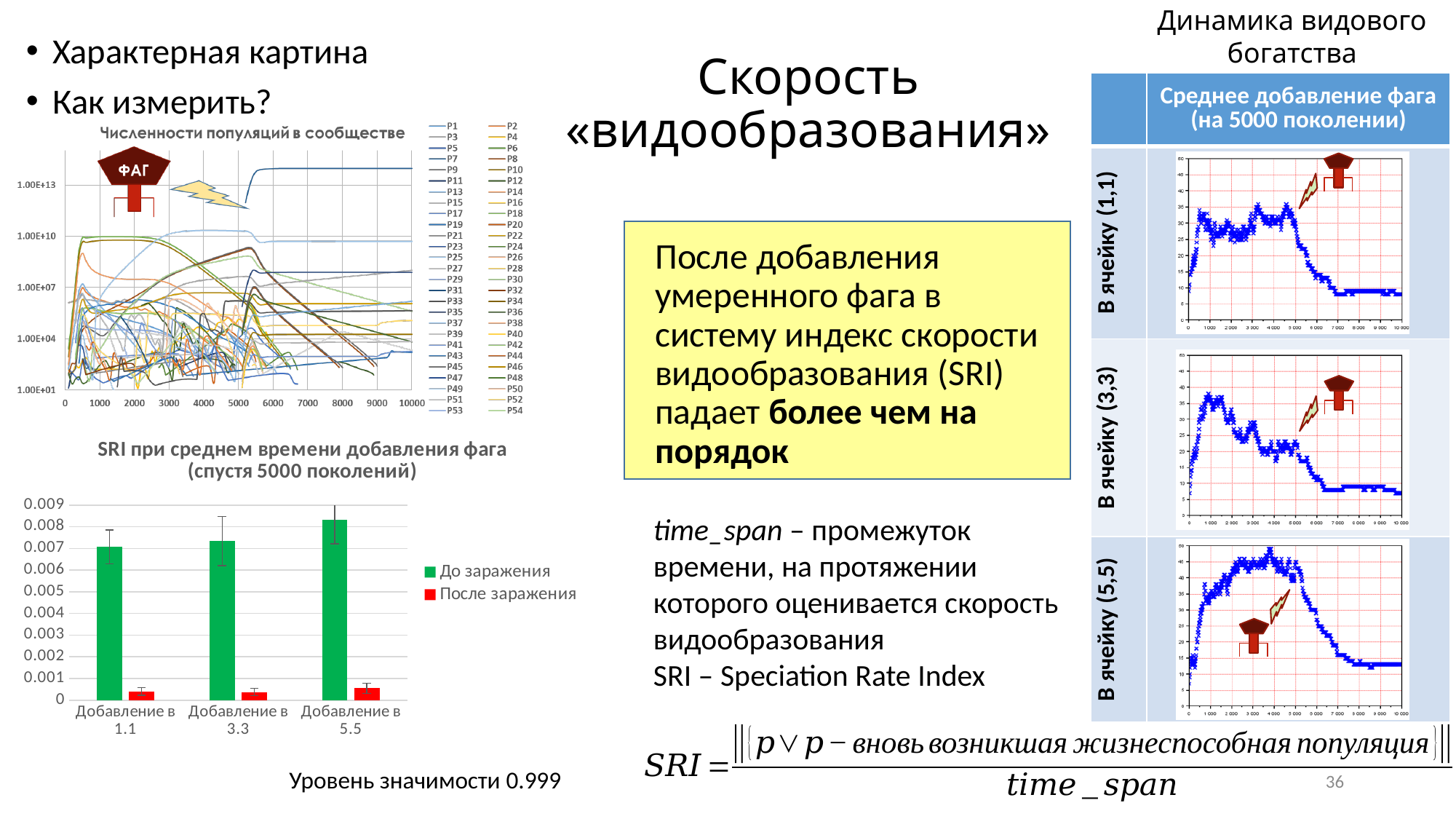
What kind of chart is "Численности популяций в сообществе"? line chart In the chart "SRI при среднем времени добавления фага", what colour are the "После заражения" bars? red In the chart "SRI при среднем времени добавления фага", is the "После заражения" value for "Добавление в 1.1" greater or less than 0.001? less How many series does the legend of the chart "SRI при среднем времени добавления фага" list? 2 How many categories are shown on the x axis of the chart "SRI при среднем времени добавления фага"? 3 What kind of chart is "SRI при среднем времени добавления фага (спустя 5000 поколений)"? bar chart In the chart "В ячейку (1,1)" under "Динамика видового богатства", do the values rise or fall along the x axis after 5000? fall How many series does the legend of the chart "Численности популяций в сообществе" list? 54 In the chart "SRI при среднем времени добавления фага", for "Добавление в 3.3", which is larger: "До заражения" or "После заражения"? До заражения In the chart "SRI при среднем времени добавления фага", which category has the highest "До заражения" value? Добавление в 5.5